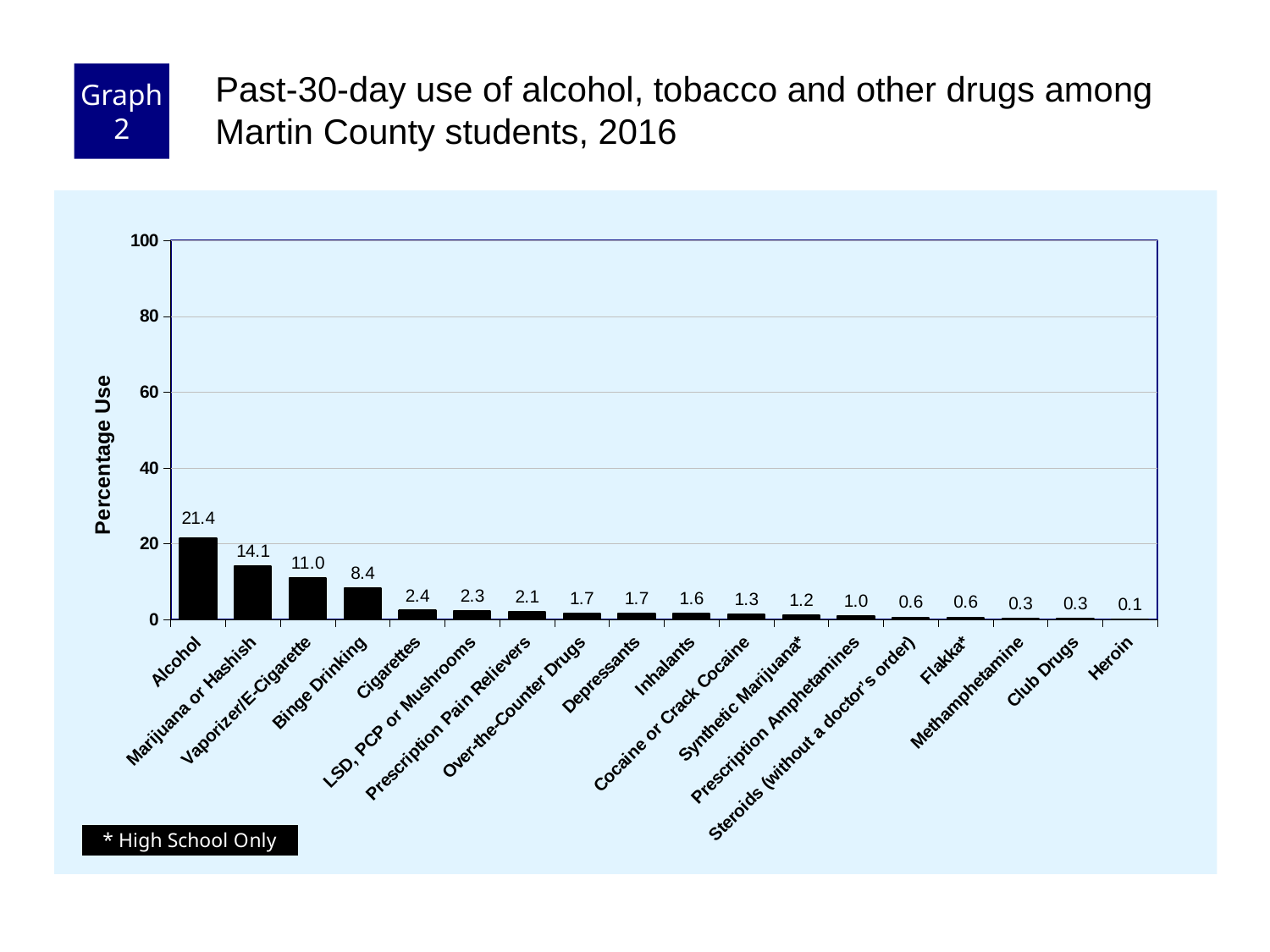
Which category has the lowest past-30-day use? Heroin How many categories are shown on the x axis? 18 What is the value shown for Heroin? 0.1 Which is larger, the value for Cigarettes or the value for Binge Drinking? Binge Drinking What is the value shown for Binge Drinking? 8.4 What is the past-30-day use percentage for Alcohol? 21.4 What is the value shown for Vaporizer/E-Cigarette? 11.0 What is the difference between the values for Alcohol and Marijuana or Hashish? 7.3 What is the label of the y axis? Percentage Use Which category has the highest past-30-day use? Alcohol Is the value for Alcohol greater or less than 20? greater What kind of chart is shown on the slide? Bar chart